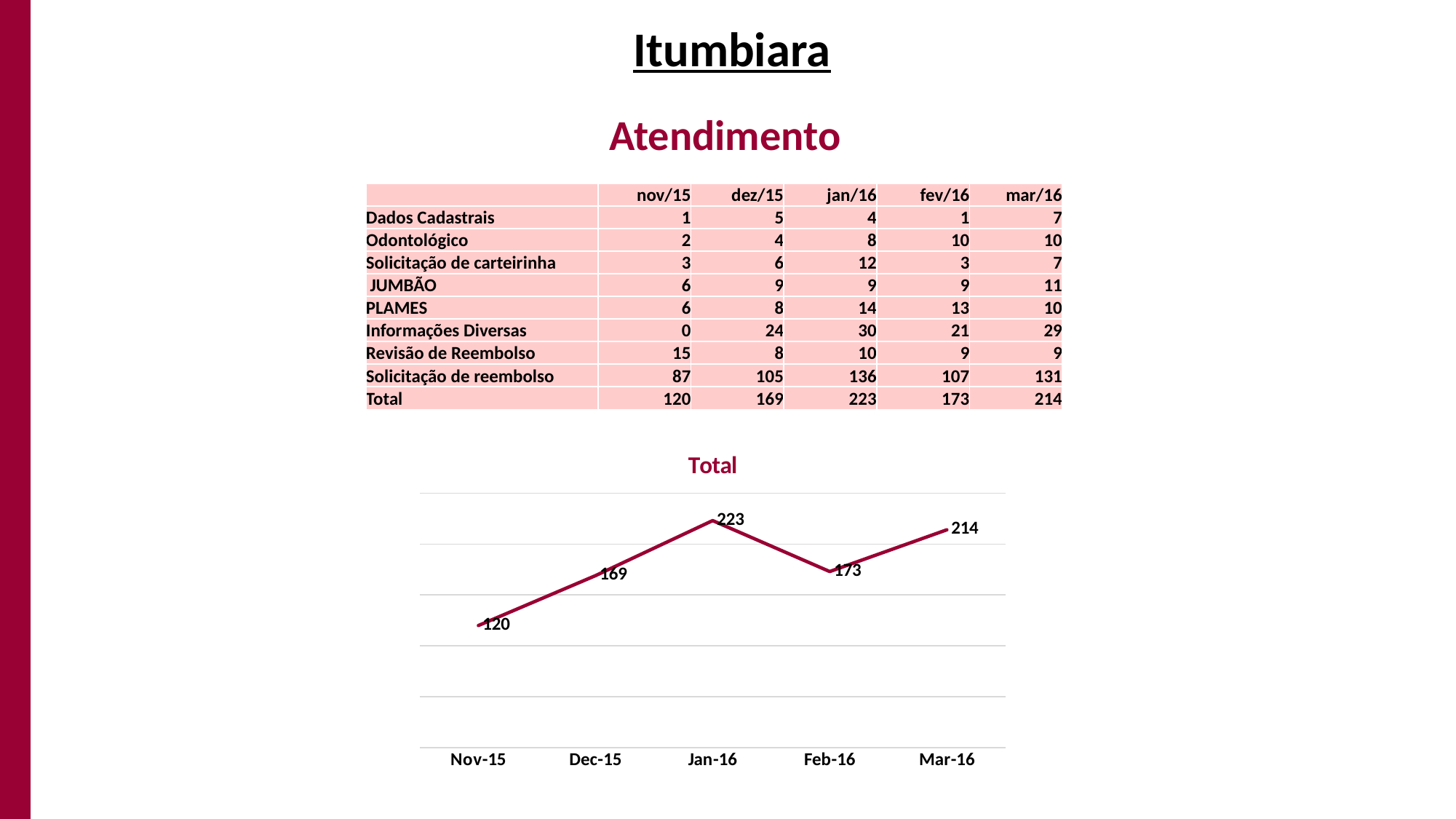
Does the value in the Total chart rise or fall from Nov-15 to Jan-16? rise What is the title of the chart on the slide? Total Which month has the highest value in the Total chart? Jan-16 Which is larger in the Total chart, the value for Dec-15 or the value for Feb-16? Feb-16 What is the difference between the Dec-15 and Nov-15 values in the Total chart? 49 What is the value for Nov-15 in the Total chart? 120 Which month has the lowest value in the Total chart? Nov-15 How many data points are plotted in the Total chart? 5 What is the value for Jan-16 in the Total chart? 223 What kind of chart is the Total chart? line chart What is the value for Mar-16 in the Total chart? 214 What is the difference between the Jan-16 and Feb-16 values in the Total chart? 50